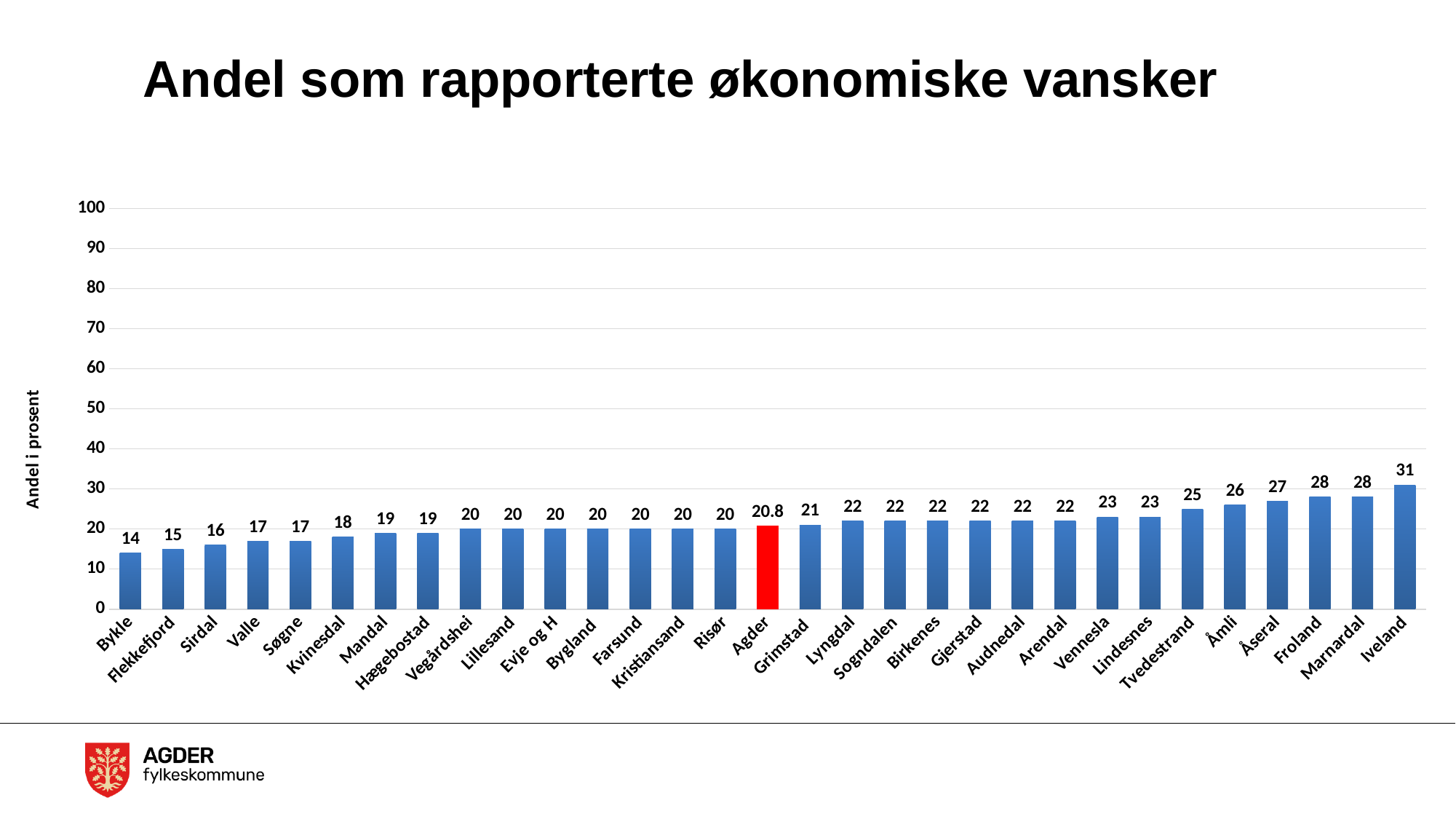
What kind of chart is shown on the slide? bar chart How many categories are shown on the x axis? 31 Which is larger, the value for Froland or the value for Vennesla? Froland Is the value for Åseral greater or less than 30? less What is the value for Kristiansand? 20 What is the difference between the values for Iveland and Bykle? 17 What is the value for Tvedestrand? 25 Do the values rise or fall from left to right along the x axis? rise Which category has the lowest value? Bykle Which bar is coloured red instead of blue? Agder What is the value for Agder? 20.8 Which category has the highest value? Iveland